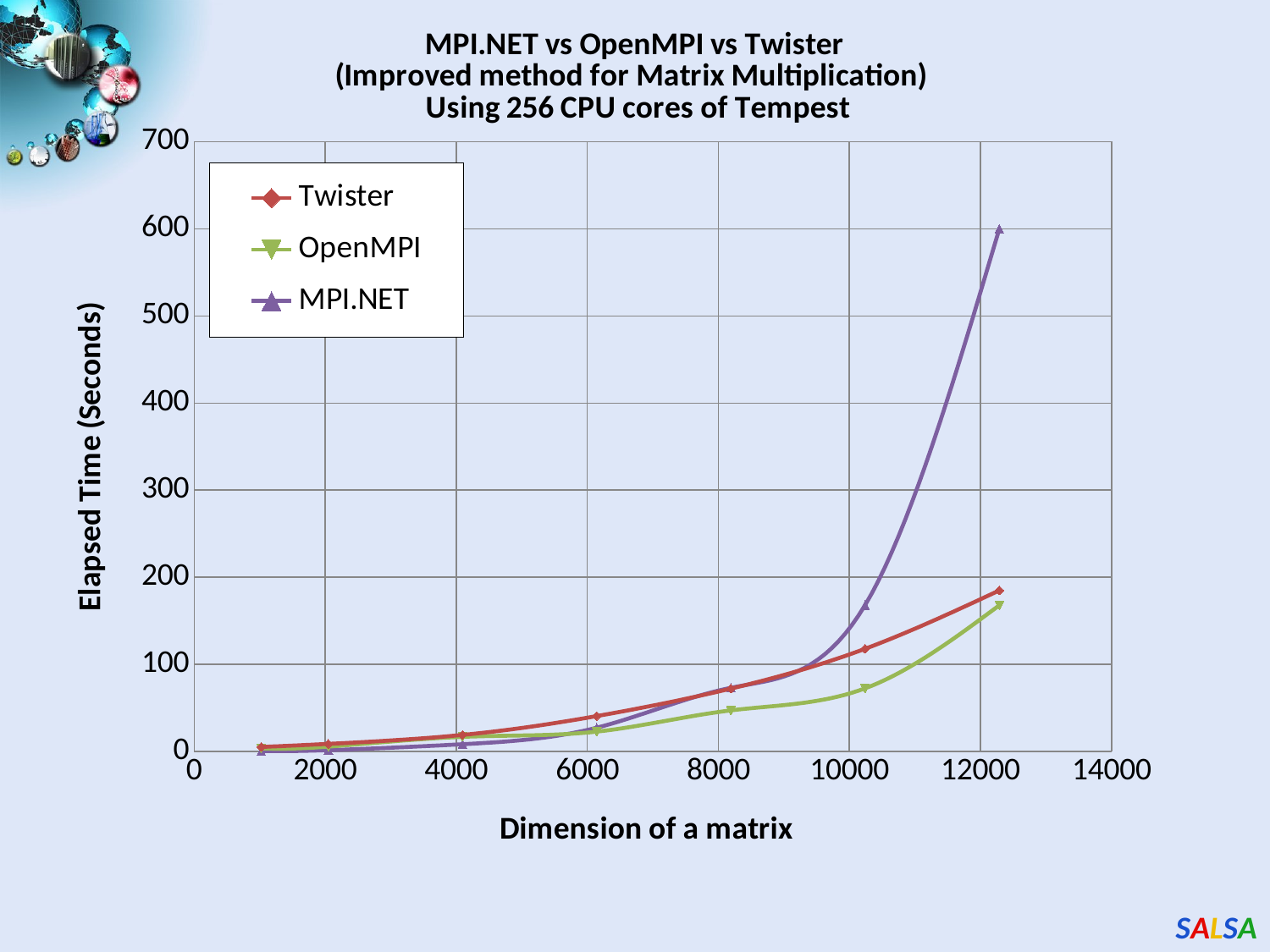
Is the elapsed time for Twister at the largest matrix dimension greater or less than 300 seconds? less Which series has the highest elapsed time at the largest matrix dimension plotted? MPI.NET Does the elapsed time for MPI.NET rise or fall as the matrix dimension increases? rise Is the elapsed time for OpenMPI at a matrix dimension of about 10000 greater or less than 100 seconds? less What kind of chart is shown on the slide? line chart How many series does the legend list? 3 At a matrix dimension of about 10000, which has the larger elapsed time, Twister or OpenMPI? Twister Is the elapsed time for MPI.NET at the largest matrix dimension greater or less than 500 seconds? greater What is the label of the y axis? Elapsed Time (Seconds) How many data points are plotted for the Twister series? 7 Which series are listed in the legend? Twister, OpenMPI, MPI.NET